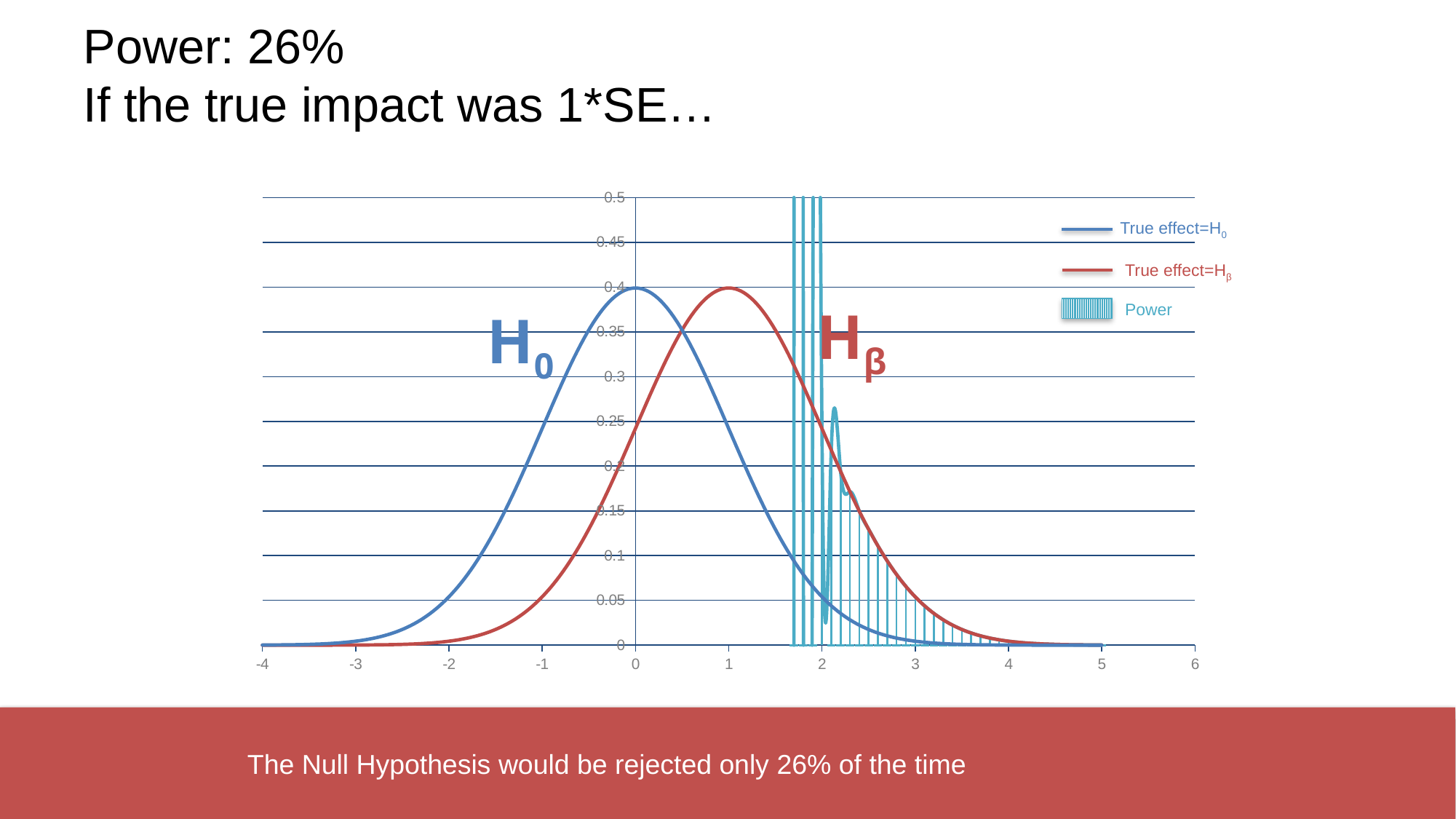
What is the lowest value shown on the chart's x axis? -4 Is the value of the red True effect=Hβ curve at x = 3 greater or less than 0.1? less What are the three entries in the chart legend? True effect=H0, True effect=Hβ, Power What kind of chart is shown on the slide? line chart At which x-axis value does the red True effect=Hβ curve reach its peak? 1 What is the highest value shown on the chart's y axis? 0.5 Is the peak value of the blue True effect=H0 curve greater or less than 0.35? greater How many entries does the chart legend list? 3 At x = 2, which curve is higher: True effect=H0 or True effect=Hβ? True effect=Hβ Does the blue True effect=H0 curve rise or fall as x goes from 0 to 4? fall At which x-axis value does the blue True effect=H0 curve reach its peak? 0 At x = 0, which curve is higher: True effect=H0 or True effect=Hβ? True effect=H0